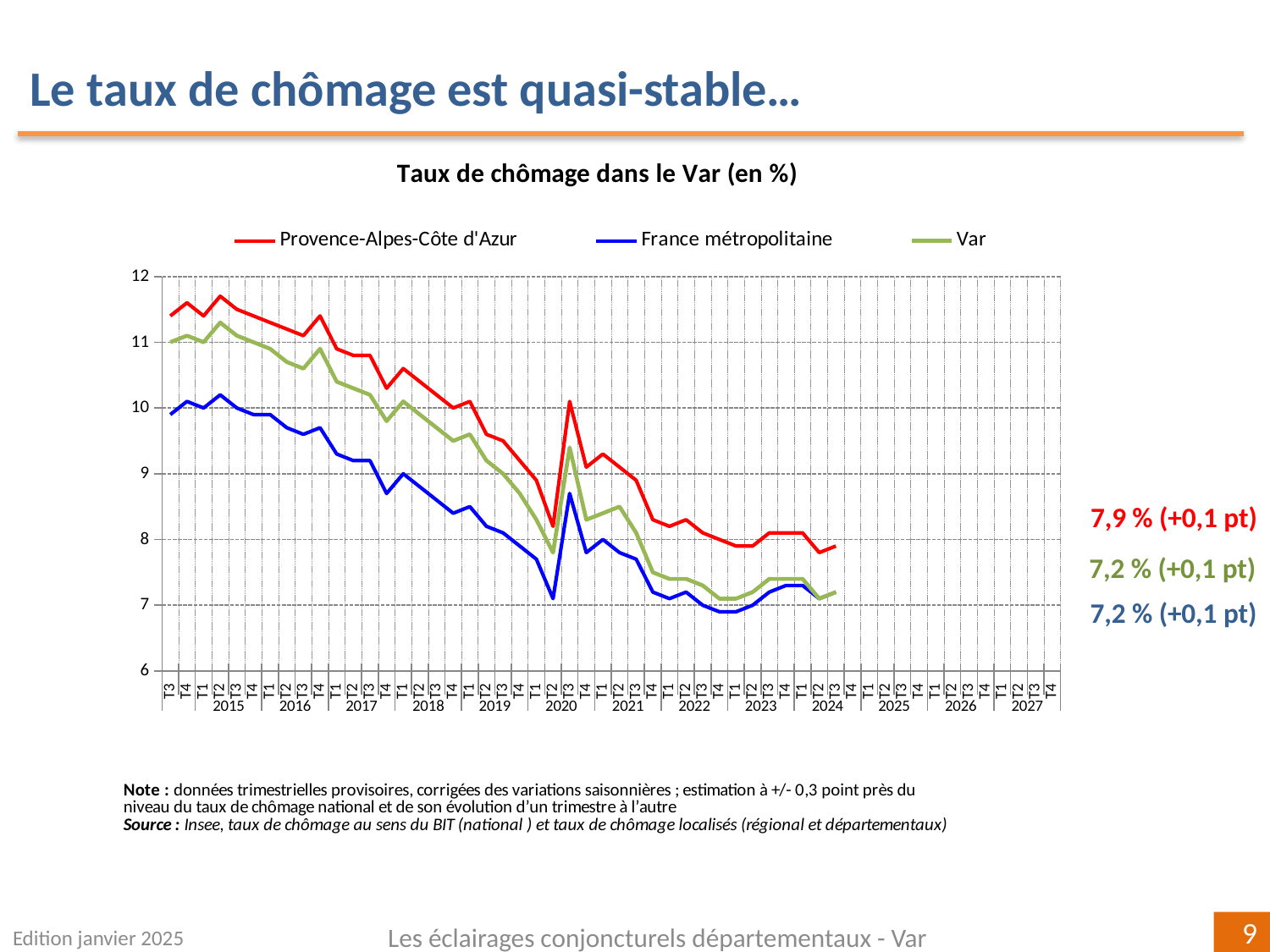
What is the latest unemployment rate shown for Provence-Alpes-Côte d'Azur? 7,9 % What is the latest unemployment rate shown for France métropolitaine? 7,2 % What is the latest unemployment rate shown for the Var? 7,2 % What kind of chart is shown on the slide? line chart Overall, do the unemployment rates rise or fall from 2015 to 2024? fall How many series does the legend list? 3 Is the value for Provence-Alpes-Côte d'Azur in T2 2015 greater or less than 11? greater Which series has the highest values across the whole period? Provence-Alpes-Côte d'Azur What is the difference between the latest rates for Provence-Alpes-Côte d'Azur and the Var? 0,7 pt What is the title of the chart? Taux de chômage dans le Var (en %) Is the value for France métropolitaine in T2 2020 greater or less than 8? less Which series has the lowest values over most of the period? France métropolitaine